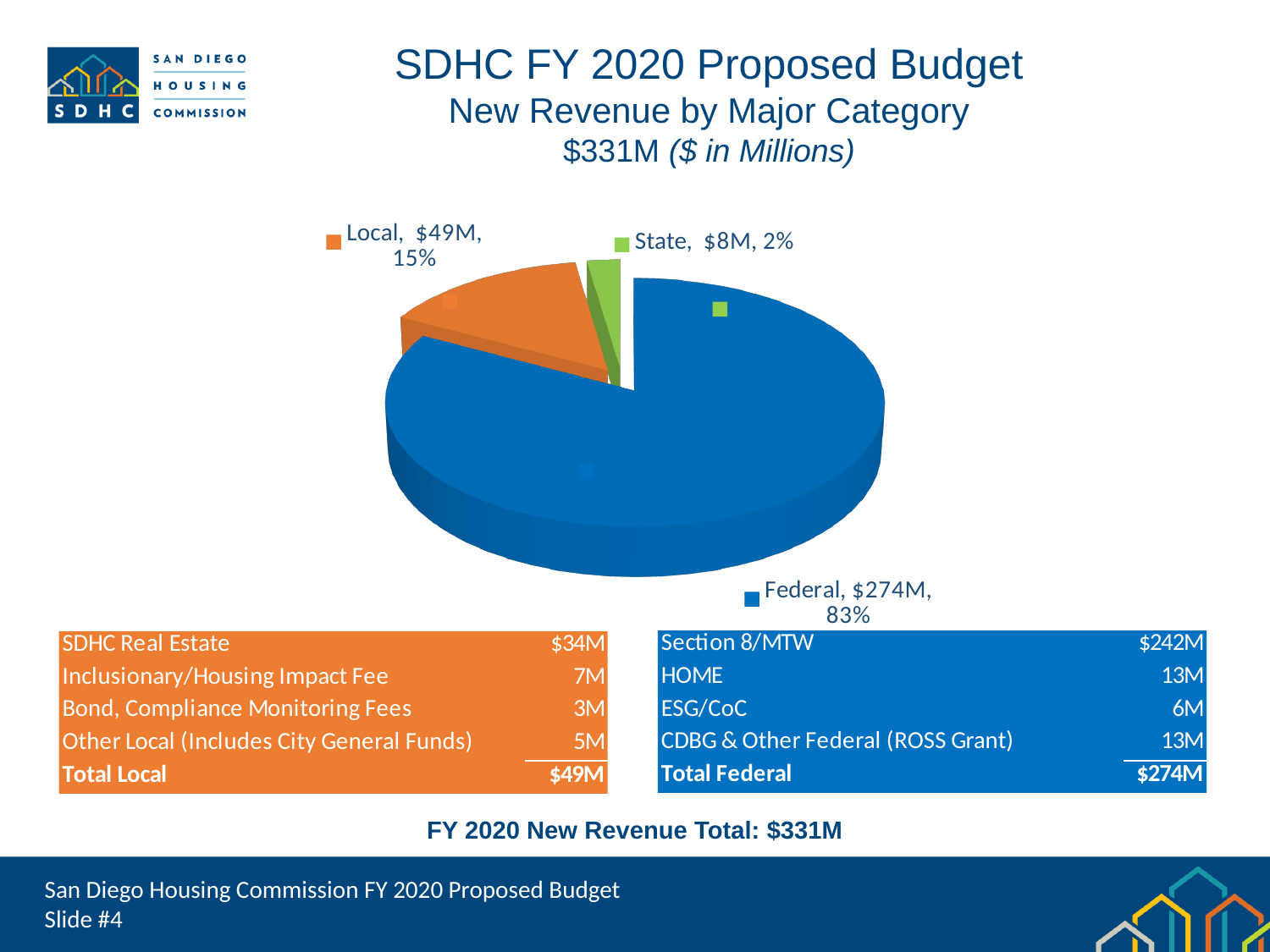
What is the value of the Local slice in the pie chart? $49M What colour is the Federal slice in the pie chart? Blue Which category is the smallest slice of the pie chart? State What share of the pie does the Federal slice represent? 83% How many slices does the pie chart have? 3 What share of the pie does the Local slice represent? 15% What is the value of the Federal slice in the pie chart? $274M What is the value of the State slice in the pie chart? $8M What kind of chart is shown on the slide? Pie chart What is the difference between the Federal and Local values in the pie chart? $225M Which category is the largest slice of the pie chart? Federal Which is larger in the pie chart, Local or State? Local